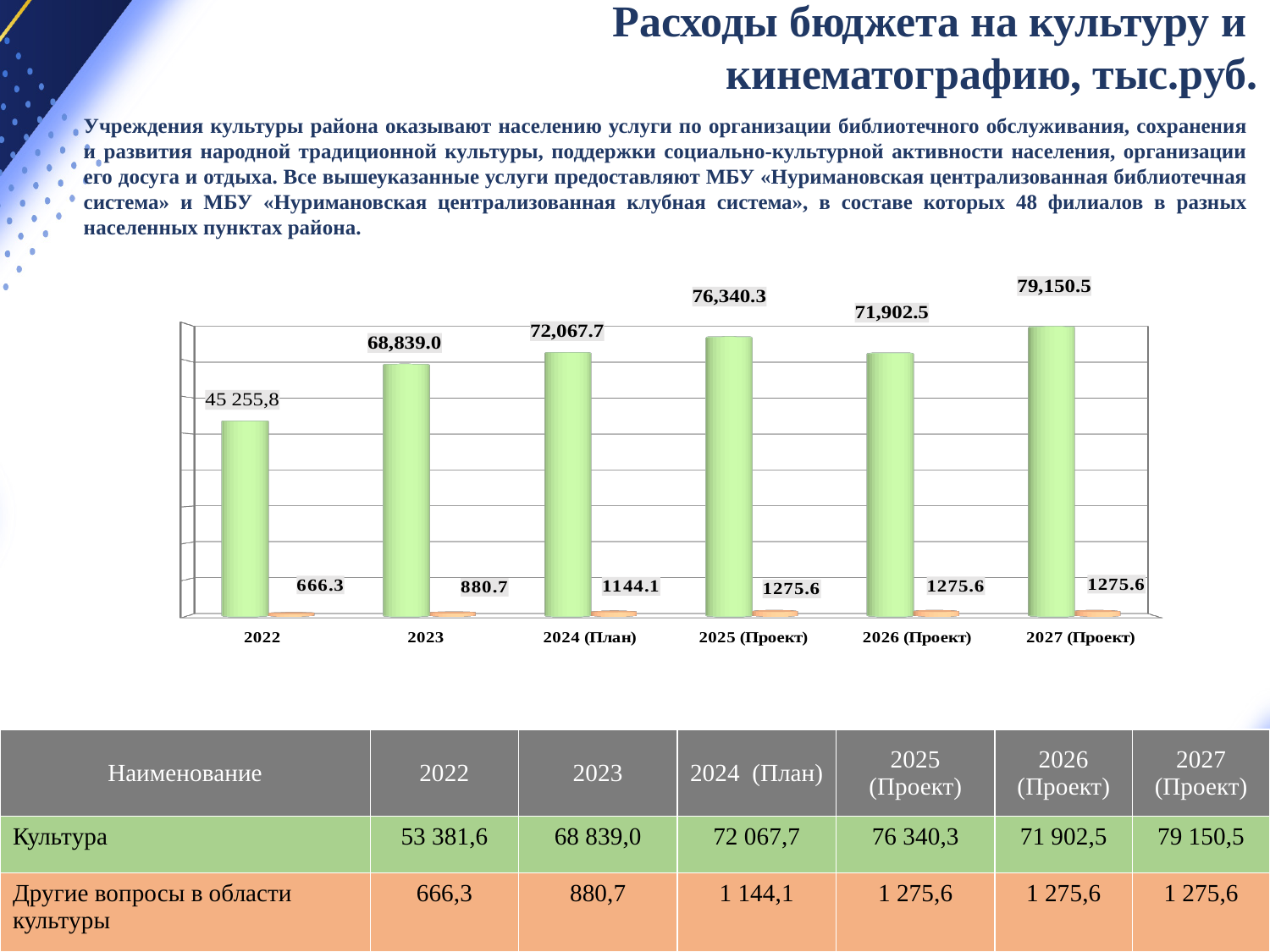
How many year categories are shown on the x axis of the chart? 6 What is the value of the orange bar for 2024 (План)? 1144.1 Which green bar is larger, 2025 (Проект) or 2026 (Проект)? 2025 (Проект) Which year has the lowest green bar? 2022 What kind of chart is shown on the slide? bar chart What is the difference between the green bar values for 2027 (Проект) and 2026 (Проект)? 7,248.0 Which year has the highest green bar? 2027 (Проект) What is the value of the green bar for 2025 (Проект)? 76,340.3 What is the value of the orange bar for 2022? 666.3 What is the difference between the orange bar values for 2023 and 2022? 214.4 What is the value of the green bar for 2023? 68,839.0 Do the green bars rise or fall from 2022 to 2025 (Проект)? rise